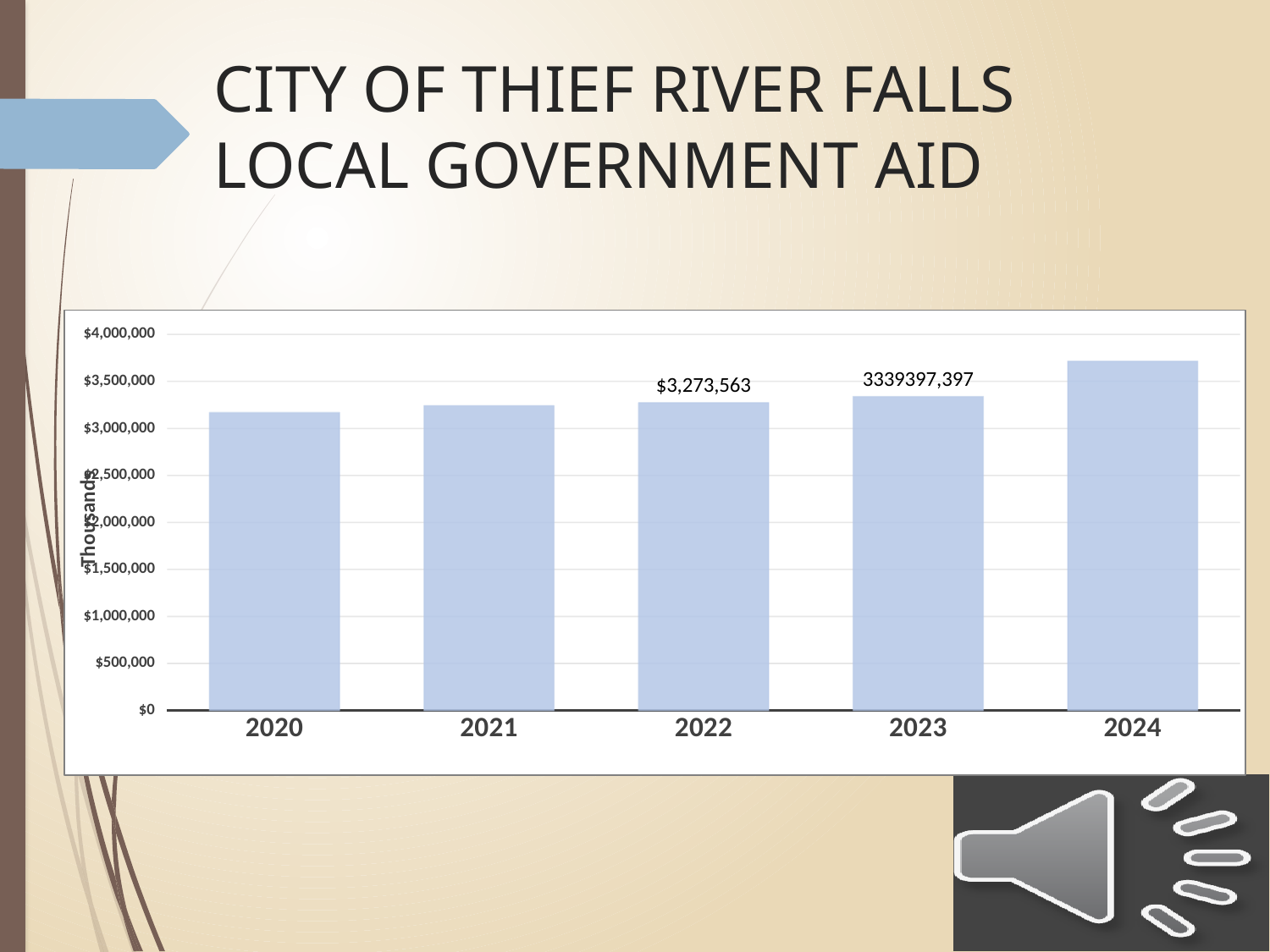
What is the value shown for 2022? $3,273,563 Is the value for 2024 greater or less than $3,500,000? greater What kind of chart is shown on the slide? bar chart How many years are shown on the x axis of the chart? 5 What is the label on the vertical axis of the chart? Thousands Which year has the highest bar? 2024 Is the value for 2020 greater or less than $3,500,000? less Which year has the larger value, 2022 or 2024? 2024 Is the value for 2021 greater or less than $3,000,000? greater Which year has the lowest bar? 2020 What is the first year shown on the x axis? 2020 Do the values generally rise or fall from 2020 to 2024? rise